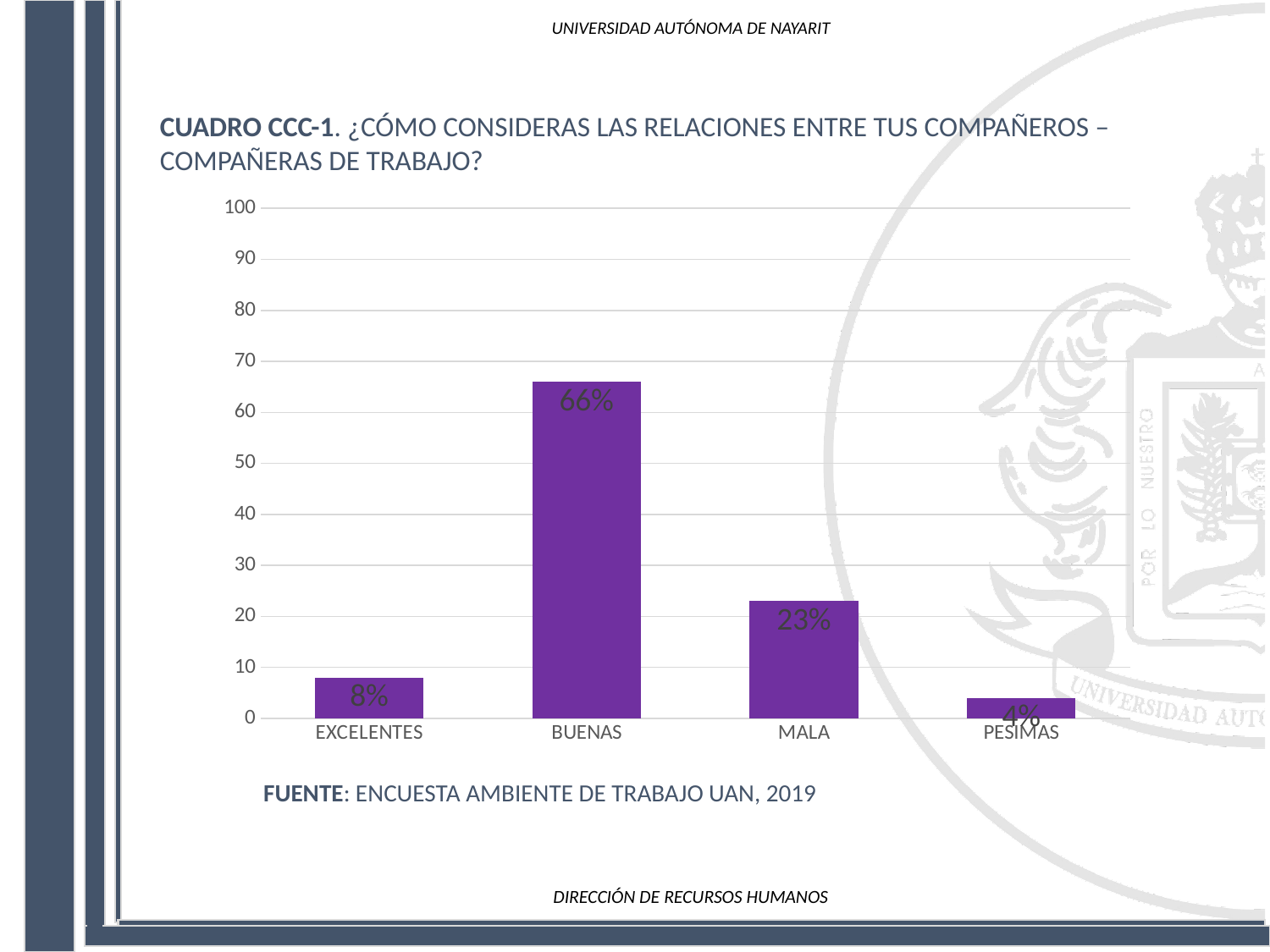
What is the value for EXCELENTES? 8% Is the value for BUENAS greater or less than 60? greater What is the value for MALA? 23% Which category has the lowest value? PESIMAS How many categories are shown on the x axis? 4 Which is larger, the value for EXCELENTES or the value for MALA? MALA What kind of chart is shown on the slide? bar chart Which category has the highest value? BUENAS What is the value for BUENAS? 66% What source is cited below the chart? ENCUESTA AMBIENTE DE TRABAJO UAN, 2019 What is the value for PESIMAS? 4% What is the difference between the values for BUENAS and MALA? 43%